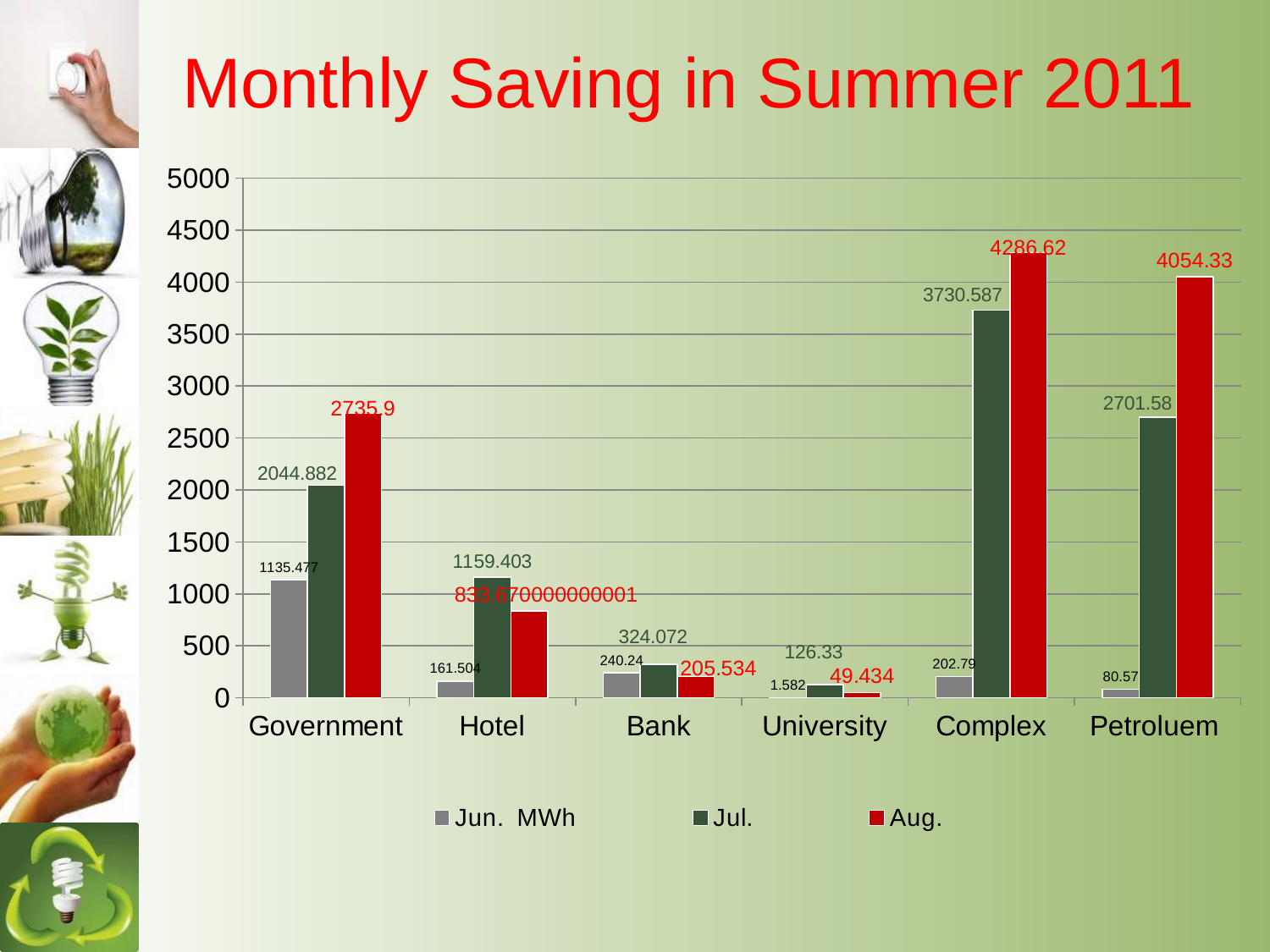
What is the Aug. value for University? 49.434 Which category has the lowest Jun. value? University Is the Jul. value for Complex greater or less than 3500? greater How many categories are shown on the x axis? 6 What is the difference between the Aug. and Jul. values for Petroluem? 1352.75 What is the Jul. value for Government? 2044.882 What kind of chart is shown on the slide? Bar chart How many series does the legend list? 3 What is the Aug. value for Complex? 4286.62 Which is larger for Bank: the Jun. value or the Jul. value? Jul. What is the Jun. value for Petroluem? 80.57 Which category has the highest Aug. value? Complex